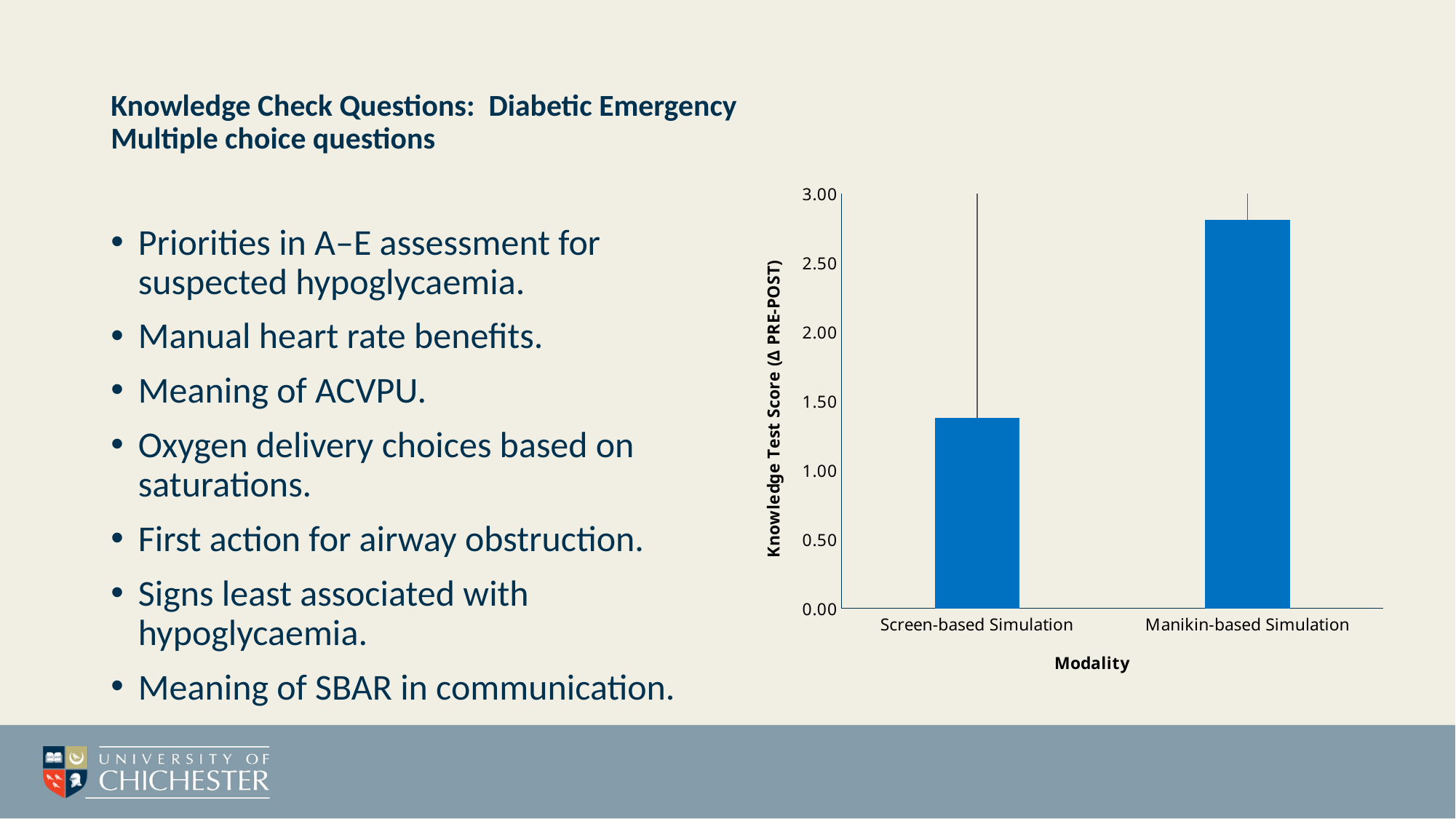
Is the value for Screen-based Simulation greater or less than 1.00? greater Is the value for Screen-based Simulation greater or less than 1.50? less Is the value for Manikin-based Simulation greater or less than 3.00? less What is the maximum value shown on the y axis of the chart? 3.00 What is the label of the x axis of the chart? Modality Is the bar for Manikin-based Simulation larger or smaller than the bar for Screen-based Simulation? larger How many modalities (bars) are plotted in the chart? 2 What is the label of the y axis of the chart? Knowledge Test Score (Δ PRE-POST) Which modality has the lower knowledge test score change? Screen-based Simulation Which modality has the higher knowledge test score change? Manikin-based Simulation What kind of chart is shown on the slide? bar chart